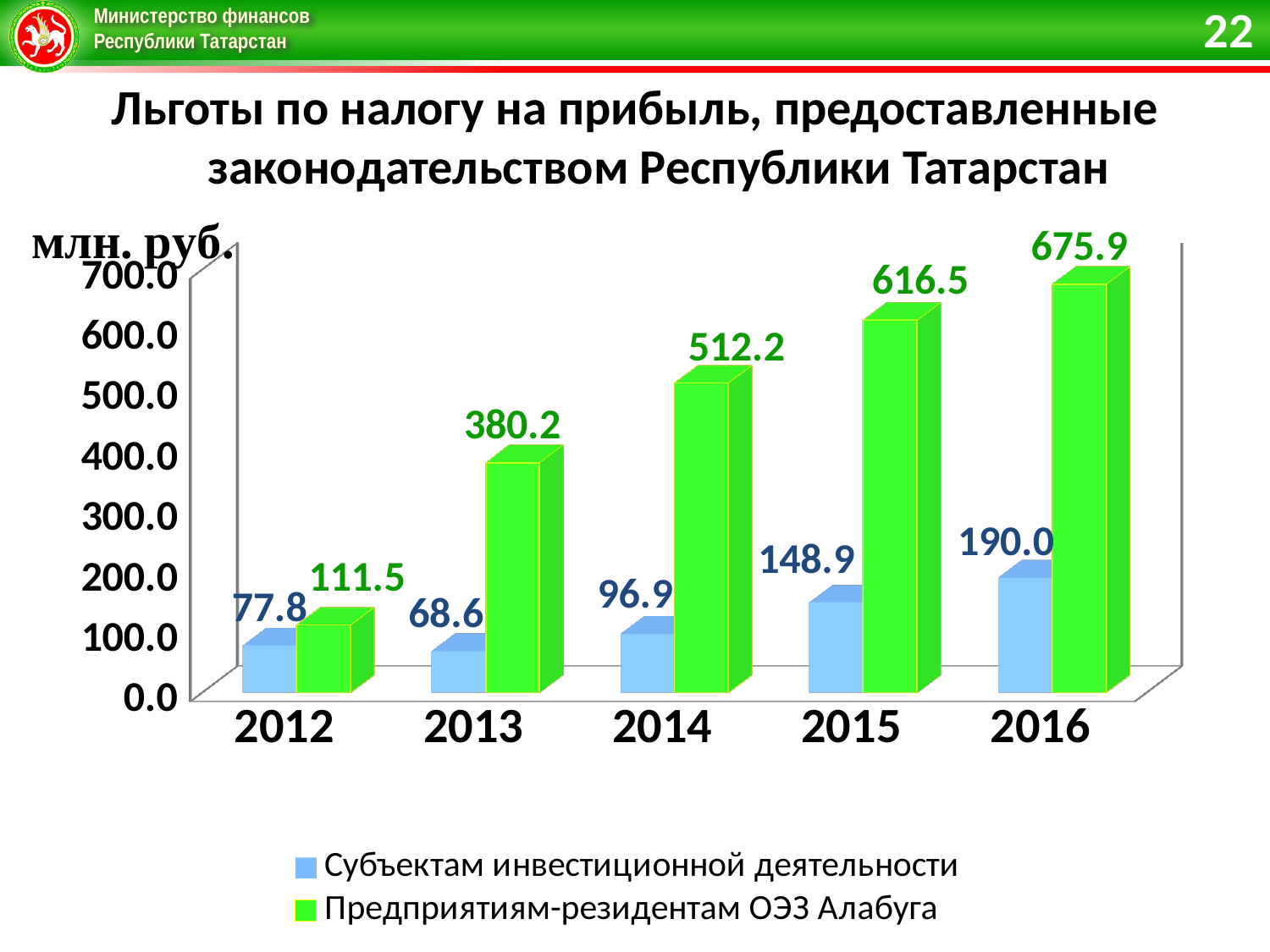
What is the difference between the 2016 and 2015 values for Предприятиям-резидентам ОЭЗ Алабуга? 59.4 How many series does the legend list? 2 How many years are shown on the x axis? 5 What is the difference between the two series' values in 2013? 311.6 What is the value for Субъектам инвестиционной деятельности in 2012? 77.8 What is the value for Субъектам инвестиционной деятельности in 2015? 148.9 Is the value for Предприятиям-резидентам ОЭЗ Алабуга in 2015 greater or less than 600.0? greater Which series has the larger value in 2012? Предприятиям-резидентам ОЭЗ Алабуга What is the value for Предприятиям-резидентам ОЭЗ Алабуга in 2014? 512.2 In which year is the value for Предприятиям-резидентам ОЭЗ Алабуга highest? 2016 In which year is the value for Субъектам инвестиционной деятельности lowest? 2013 What kind of chart is shown on the slide? bar chart